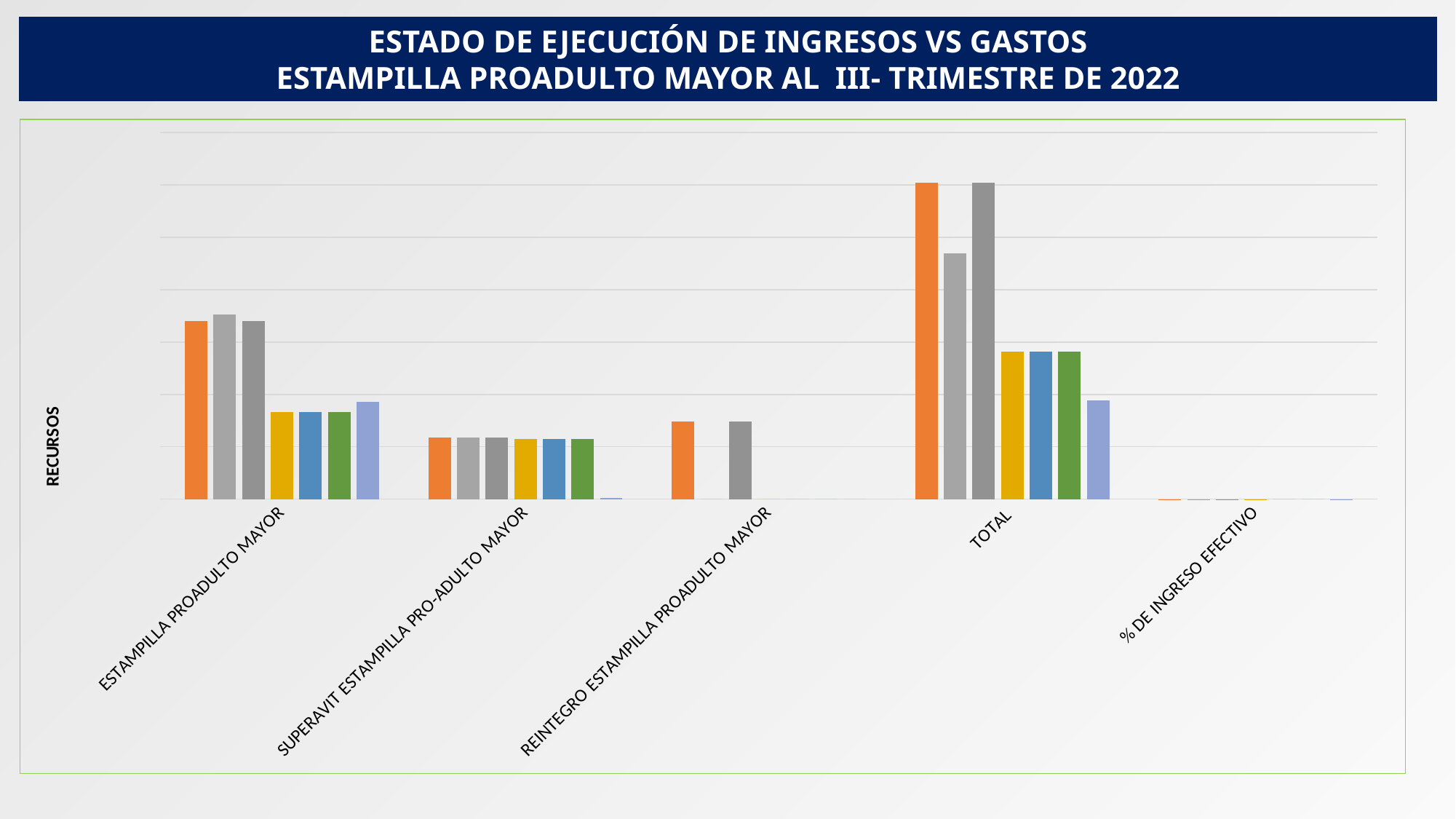
How many bars are visible for the REINTEGRO ESTAMPILLA PROADULTO MAYOR category? 2 What is the label on the vertical axis of the chart? RECURSOS How many categories are shown along the x axis of the chart? 5 What kind of chart is shown on the slide? Bar chart Is the orange bar taller for ESTAMPILLA PROADULTO MAYOR or for SUPERAVIT ESTAMPILLA PRO-ADULTO MAYOR? ESTAMPILLA PROADULTO MAYOR Within the TOTAL category, is the light gray bar taller or shorter than the dark gray bar? Shorter Which category is plotted immediately to the left of TOTAL on the x axis? REINTEGRO ESTAMPILLA PROADULTO MAYOR What is the title of the chart on the slide? ESTADO DE EJECUCIÓN DE INGRESOS VS GASTOS ESTAMPILLA PROADULTO MAYOR AL III- TRIMESTRE DE 2022 Which category has the smallest bars in the chart? % DE INGRESO EFECTIVO Within the TOTAL category, is the orange bar taller or shorter than the gold bar? Taller Which category has the tallest bars in the chart? TOTAL